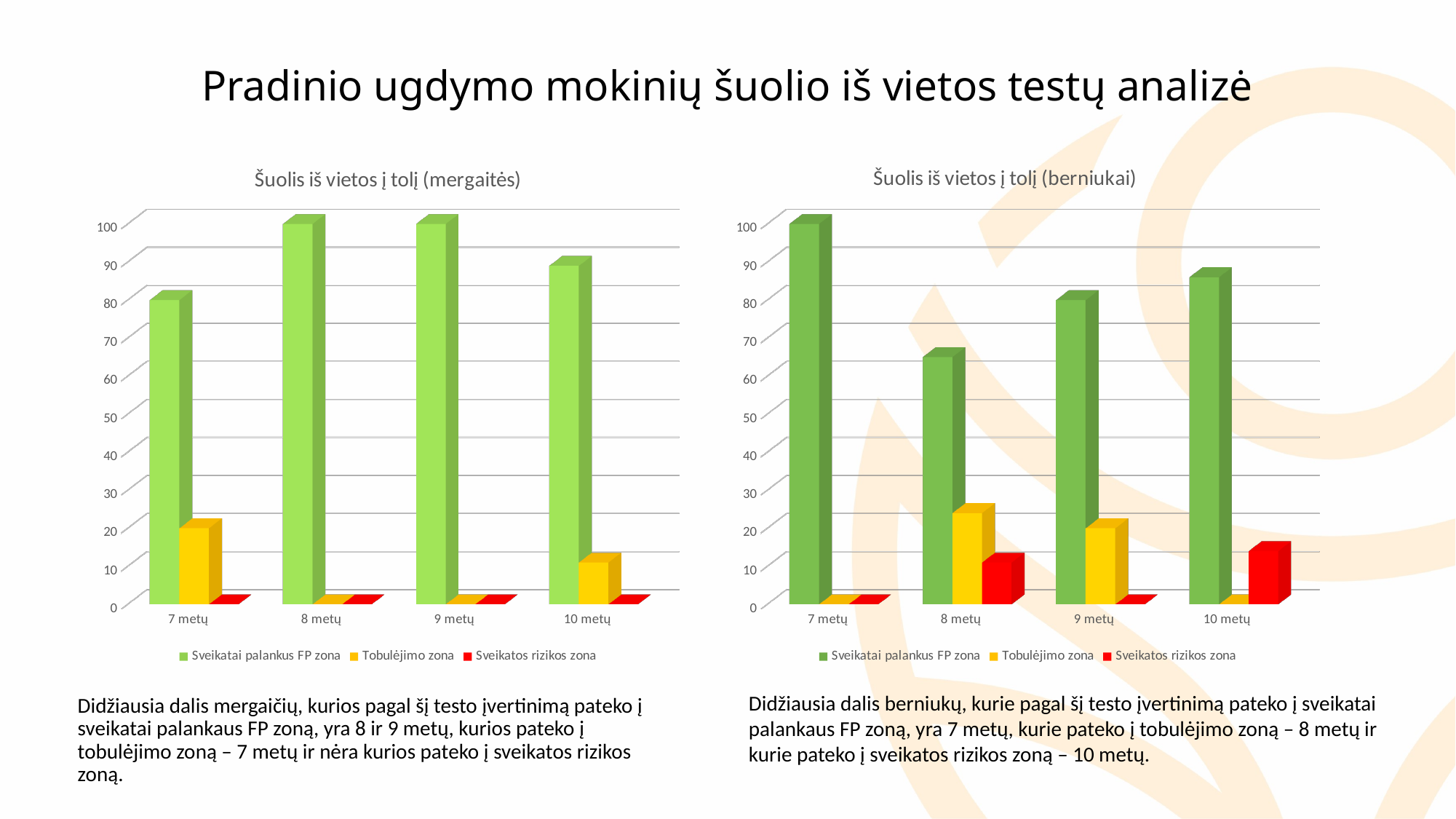
In "Šuolis iš vietos į tolį (berniukai)", which age group has the highest value for Sveikatos rizikos zona? 10 metų In "Šuolis iš vietos į tolį (berniukai)", which age group has the highest value for Sveikatai palankus FP zona? 7 metų How many age categories are shown on the x axis of "Šuolis iš vietos į tolį (mergaitės)"? 4 In "Šuolis iš vietos į tolį (berniukai)", is the Tobulėjimo zona value for 8 metų greater or less than 30? less In "Šuolis iš vietos į tolį (mergaitės)", which age group has the lowest value for Sveikatai palankus FP zona? 7 metų How many series does the legend of "Šuolis iš vietos į tolį (berniukai)" list? 3 In "Šuolis iš vietos į tolį (mergaitės)", is the Sveikatai palankus FP zona value for 7 metų greater or less than 70? greater In "Šuolis iš vietos į tolį (mergaitės)", which is larger for 7 metų: Tobulėjimo zona or Sveikatos rizikos zona? Tobulėjimo zona What kind of chart is "Šuolis iš vietos į tolį (mergaitės)"? bar chart In "Šuolis iš vietos į tolį (berniukai)", which age group has the lowest value for Sveikatai palankus FP zona? 8 metų Which colour represents Sveikatos rizikos zona in the legend of "Šuolis iš vietos į tolį (mergaitės)"? red In "Šuolis iš vietos į tolį (berniukai)", is the Sveikatai palankus FP zona value for 8 metų greater or less than 70? less